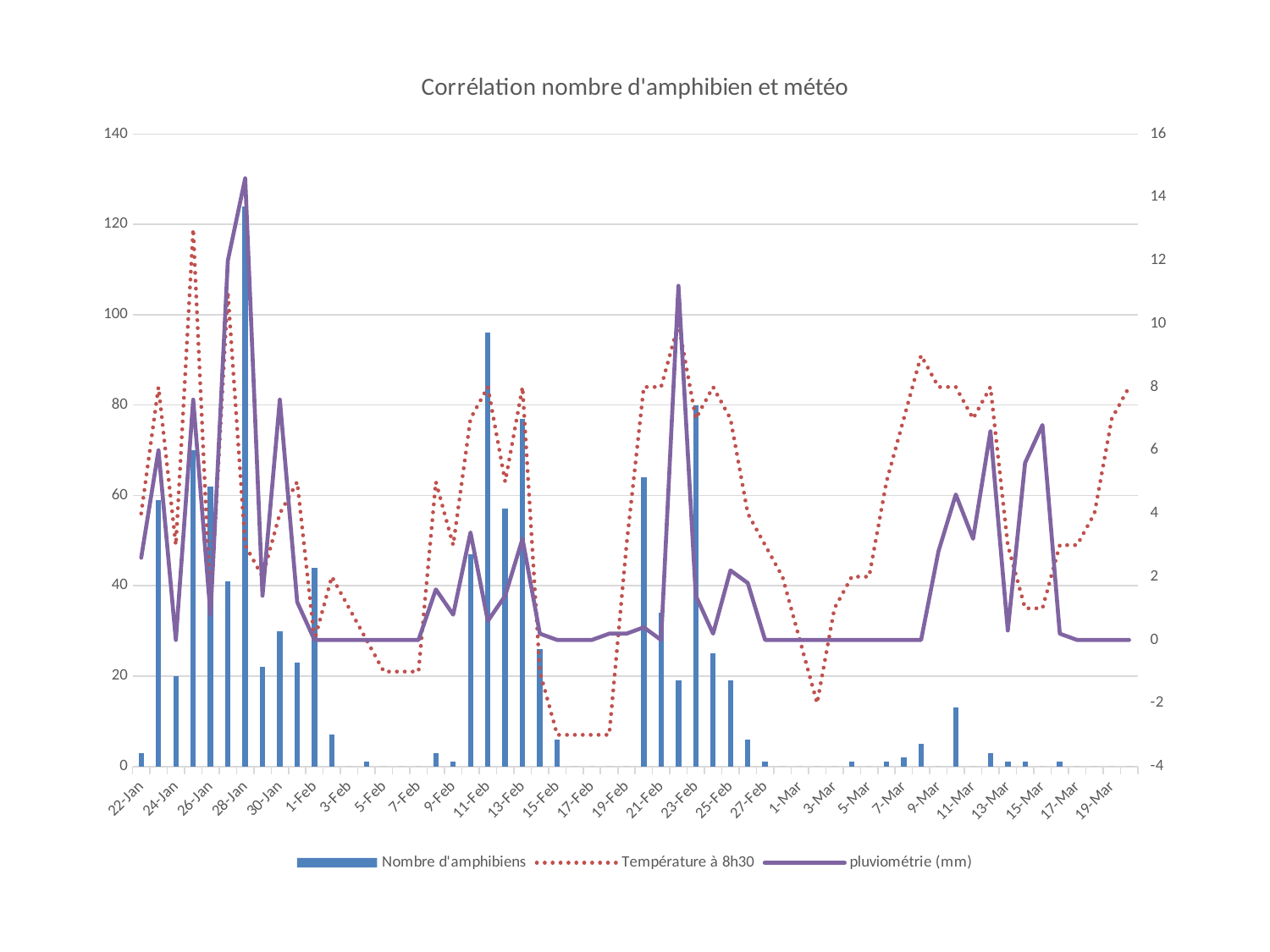
Is the Nombre d'amphibiens value for 25-Feb greater or less than 40? less What is the title of the chart? Corrélation nombre d'amphibien et météo Which has the larger Nombre d'amphibiens value, 11-Feb or 13-Feb? 11-Feb Is the Nombre d'amphibiens value for 21-Feb greater or less than 40? less Which has the larger Nombre d'amphibiens value, 26-Jan or 30-Jan? 26-Jan Is the Nombre d'amphibiens value for 11-Feb greater or less than 80? greater Which series is drawn as a dotted red line? Température à 8h30 What kind of chart is this? Combined bar and line chart On which date is the Nombre d'amphibiens bar the highest? 28-Jan How many series does the legend list? 3